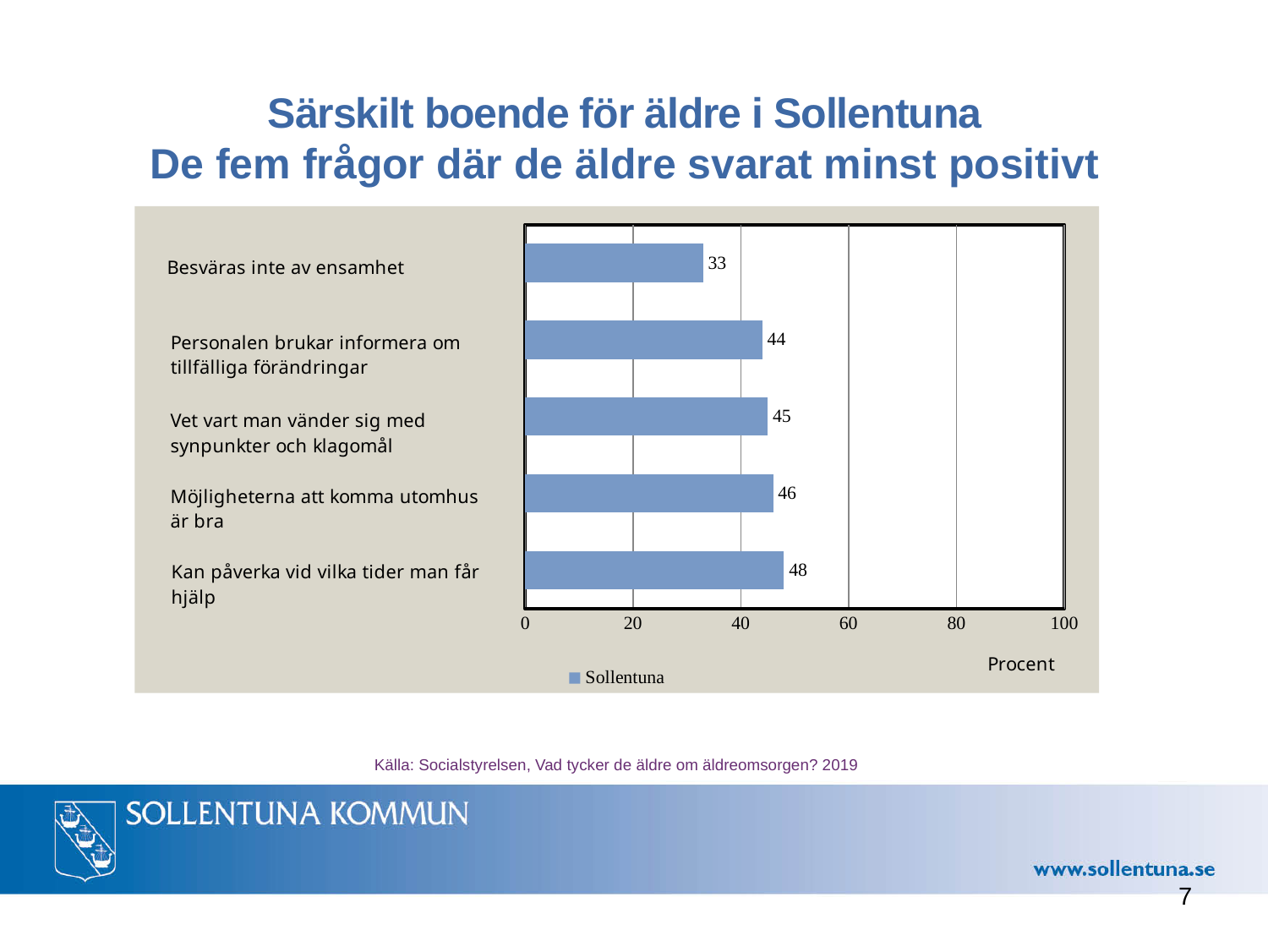
Which category has the highest value? Kan påverka vid vilka tider man får hjälp What series name is shown in the chart legend? Sollentuna What is the value for "Vet vart man vänder sig med synpunkter och klagomål"? 45 What kind of chart is shown on the slide? Bar chart Is the value for "Besväras inte av ensamhet" greater or less than 40? less What is the value for "Besväras inte av ensamhet"? 33 How many series does the legend list? 1 What is the value for "Kan påverka vid vilka tider man får hjälp"? 48 What is the difference between the values for "Kan påverka vid vilka tider man får hjälp" and "Besväras inte av ensamhet"? 15 Which is larger: the value for "Personalen brukar informera om tillfälliga förändringar" or the value for "Möjligheterna att komma utomhus är bra"? Möjligheterna att komma utomhus är bra How many categories are shown in the chart? 5 Which category has the lowest value? Besväras inte av ensamhet